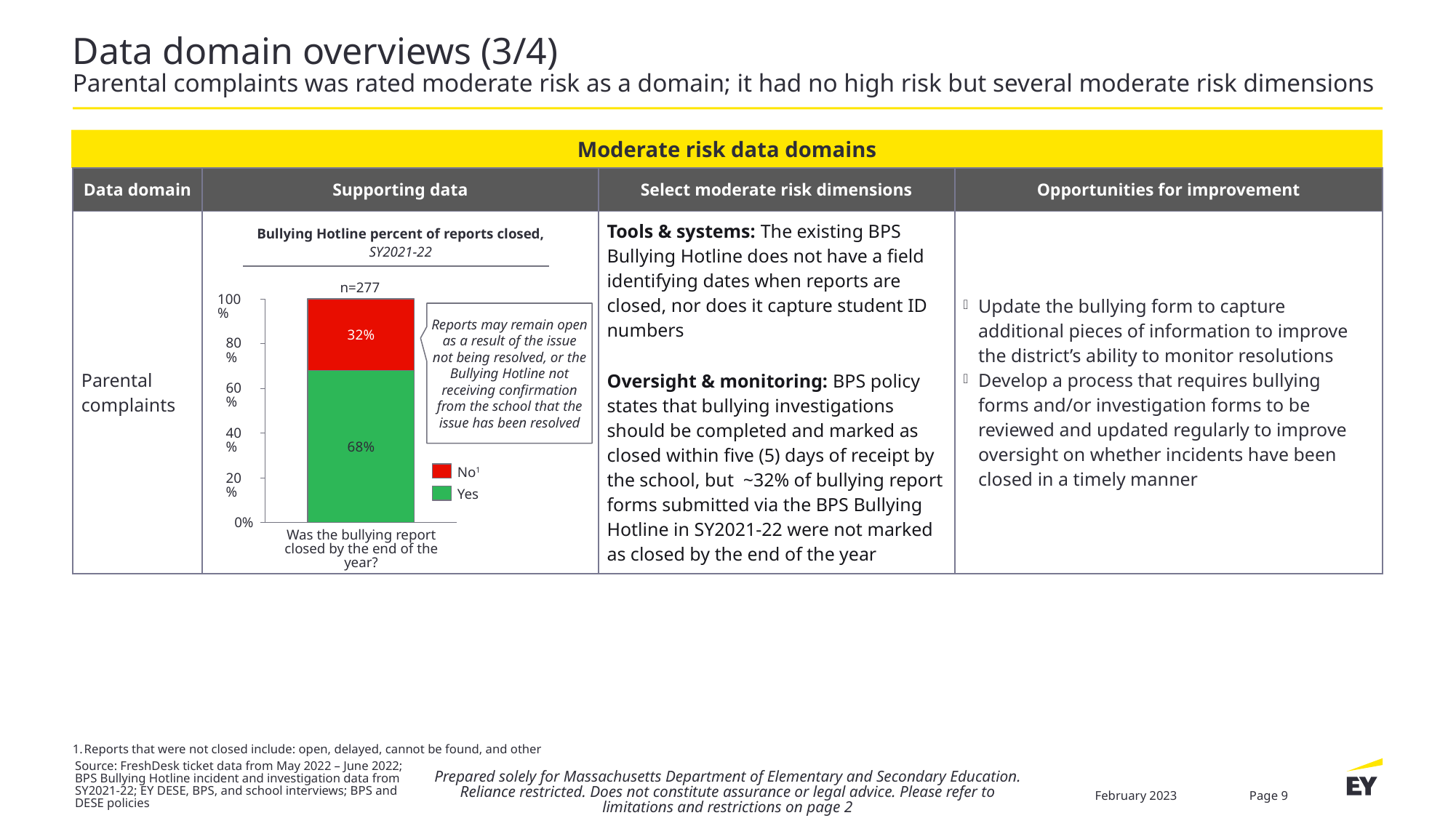
What percentage of bullying reports were closed by the end of the year (Yes)? 68% What is the difference in percentage points between the Yes and No segments? 36 What kind of chart is shown in the Supporting data column? Stacked bar chart Is the value for No greater or less than 40%? less What percentage of bullying reports were not closed by the end of the year (No)? 32% What is the title of the chart? Bullying Hotline percent of reports closed, SY2021-22 Is the value for Yes greater or less than 60%? greater Which segment of the bar is larger, Yes or No? Yes How many bars are plotted in the chart? 1 What is the total of the stacked bar? 100% How many series does the legend list? 2 What is the sample size (n) shown above the bar? n=277